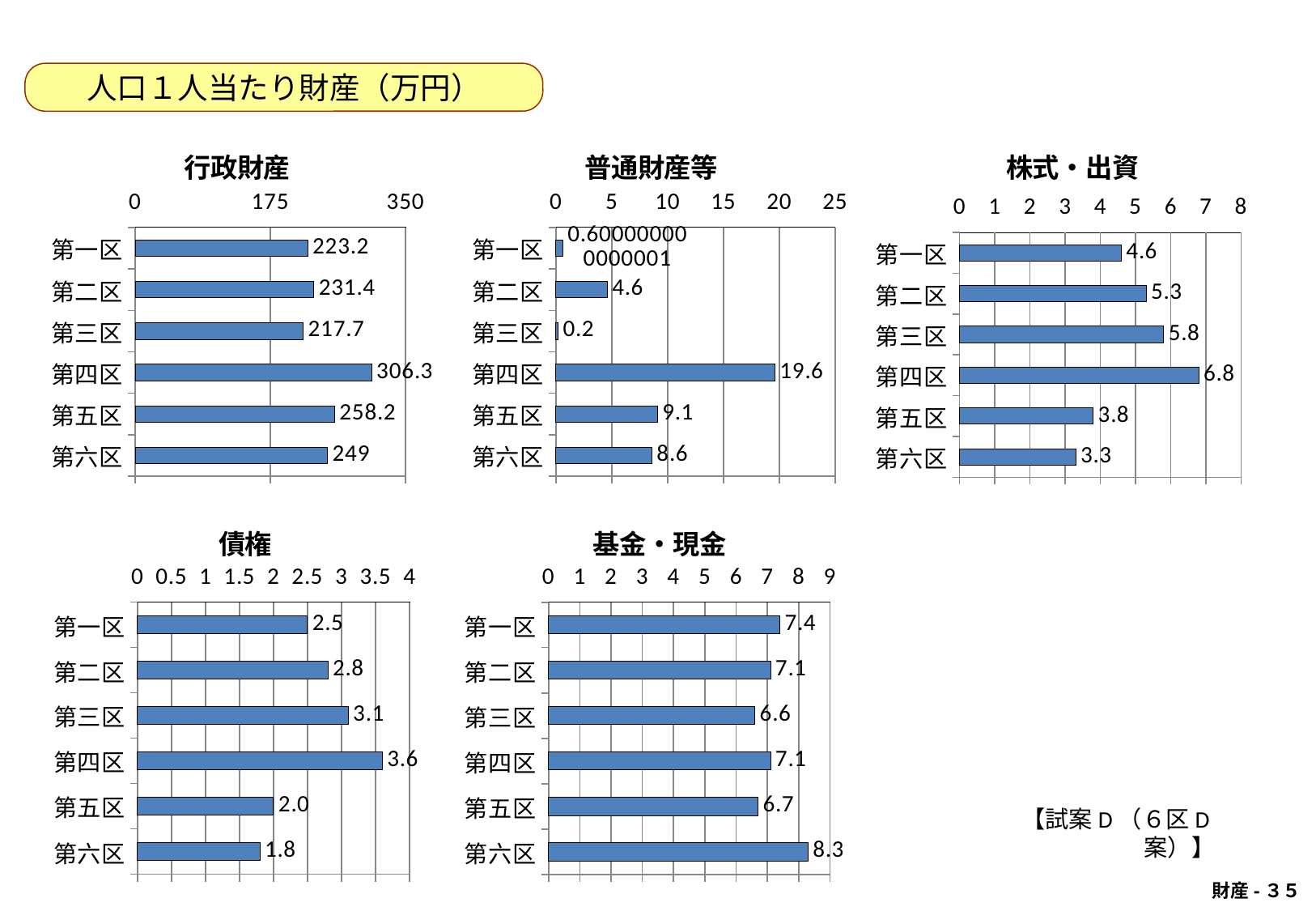
In the 行政財産 chart, what is the difference between 第五区 and 第六区? 9.2 In the 株式・出資 chart, what is the value for 第六区? 3.3 In the 基金・現金 chart, what is the value for 第六区? 8.3 In the 行政財産 chart, what is the value for 第四区? 306.3 In the 普通財産等 chart, what is the value for 第四区? 19.6 In the 株式・出資 chart, which is larger, 第二区 or 第五区? 第二区 In the 債権 chart, what is the value for 第三区? 3.1 In the 基金・現金 chart, what is the difference between 第六区 and 第三区? 1.7 How many charts are shown on the slide? 5 In the 普通財産等 chart, which district has the highest value? 第四区 In the 行政財産 chart, which district has the lowest value? 第三区 In the 債権 chart, which district has the lowest value? 第六区